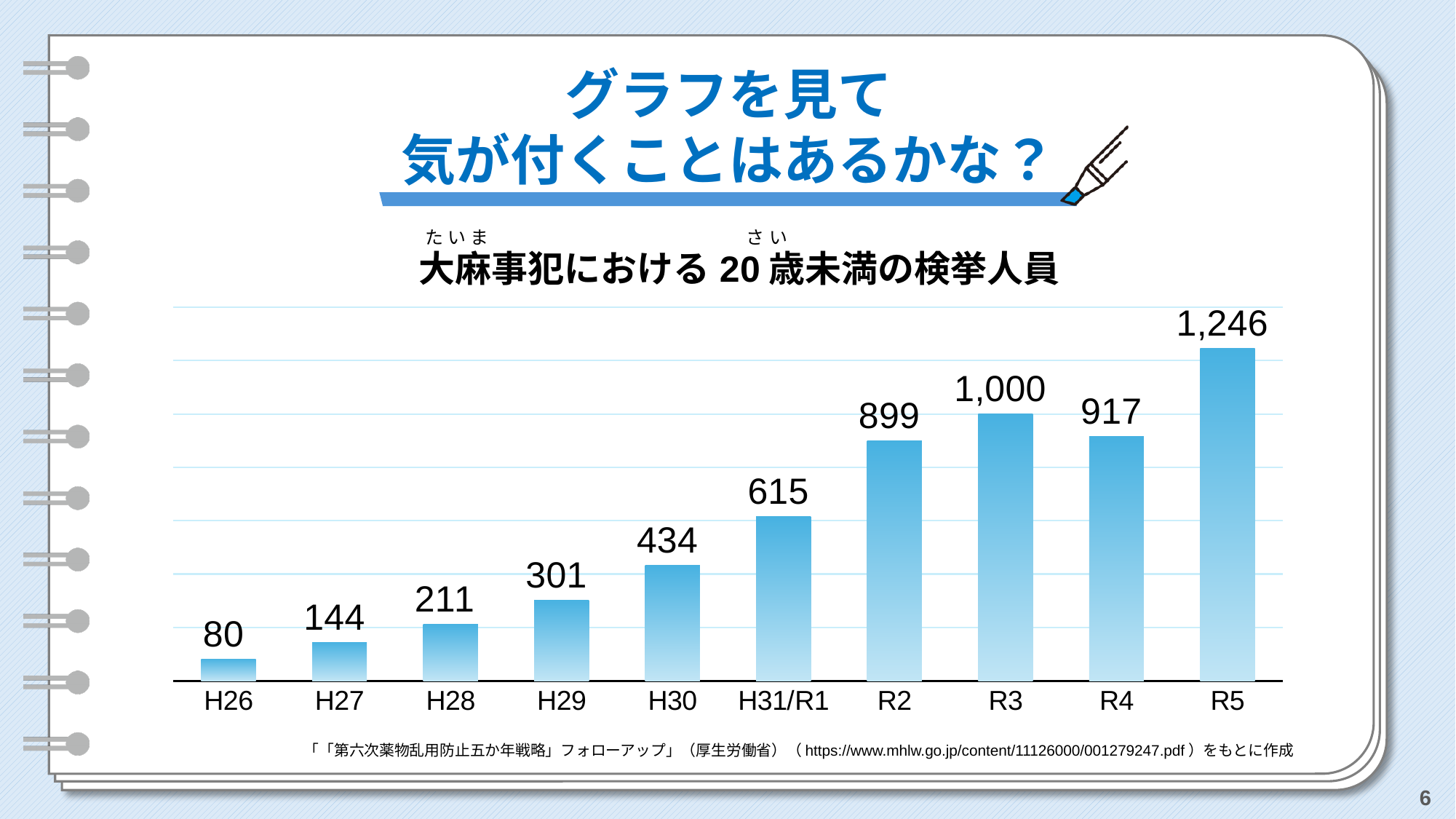
What is the value for H30? 434 Which category has the highest value? R5 Do the values generally rise or fall from H26 to R5? rise What is the value for R5? 1,246 How many categories are shown on the x axis? 10 What is the title of the chart? 大麻事犯における20歳未満の検挙人員 Which is larger, the value for R3 or the value for R4? R3 What is the difference between the values for R5 and R4? 329 What kind of chart is this? bar chart What is the difference between the values for R3 and R2? 101 What is the value for H31/R1? 615 Which category has the lowest value? H26